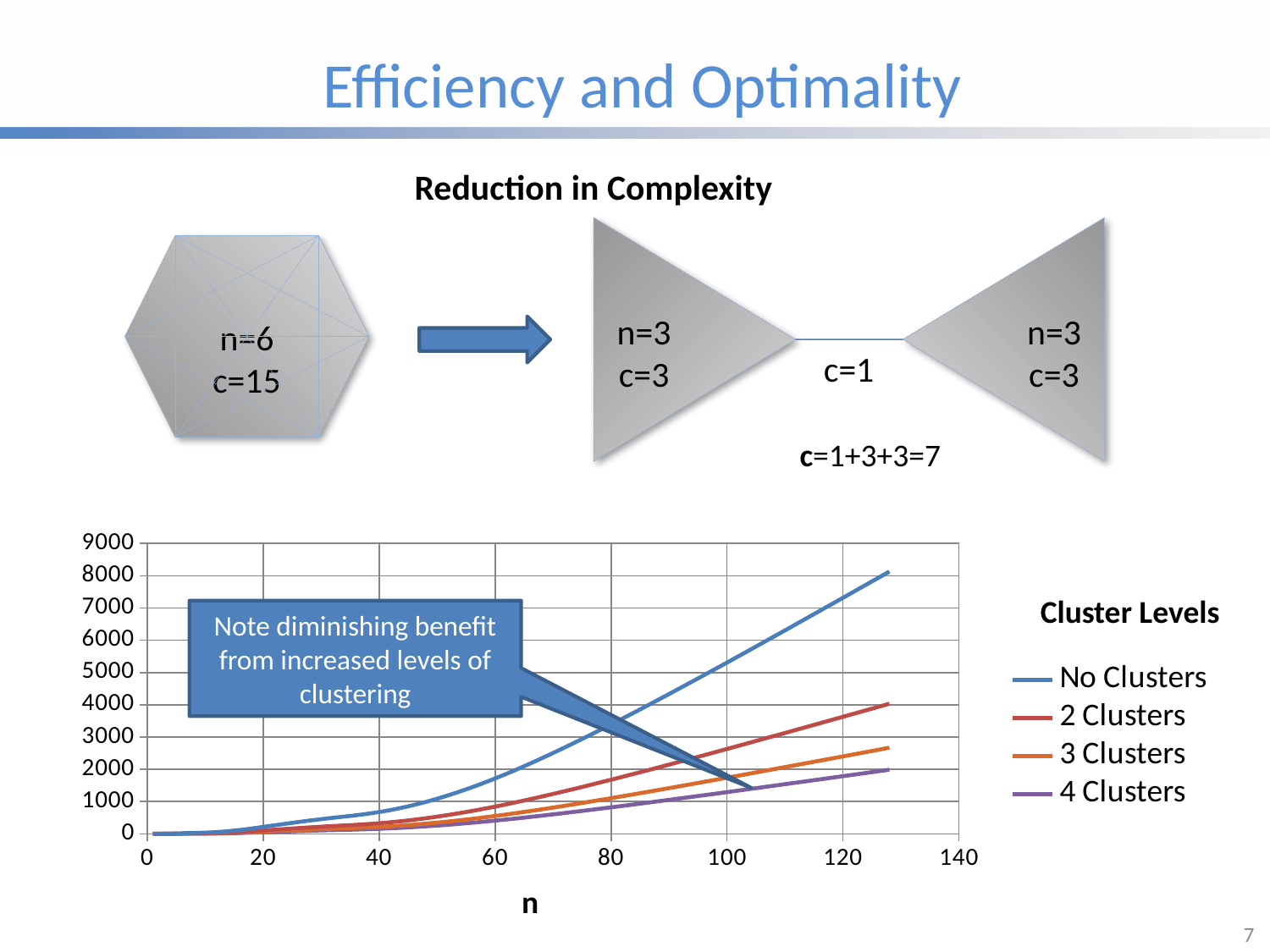
How many series does the legend of the line chart list? 4 What is the label of the x axis on the line chart? n What is the title of the legend on the line chart? Cluster Levels On the line chart, is the value of the No Clusters series at its right end greater or less than 7000? greater Which series on the line chart reaches the highest value? No Clusters On the line chart, is the value of the 3 Clusters series at its right end greater or less than 3000? less On the line chart, is the value of the 2 Clusters series at its right end greater or less than 3000? greater On the line chart, do the values of the No Clusters series rise or fall as n increases? rise What is the highest value shown on the y axis of the line chart? 9000 What kind of chart is shown at the bottom of the slide? line chart Which series on the line chart has the lowest value at the right end of the x axis? 4 Clusters On the line chart, at the right end of the x axis, which is larger: the No Clusters series or the 4 Clusters series? No Clusters